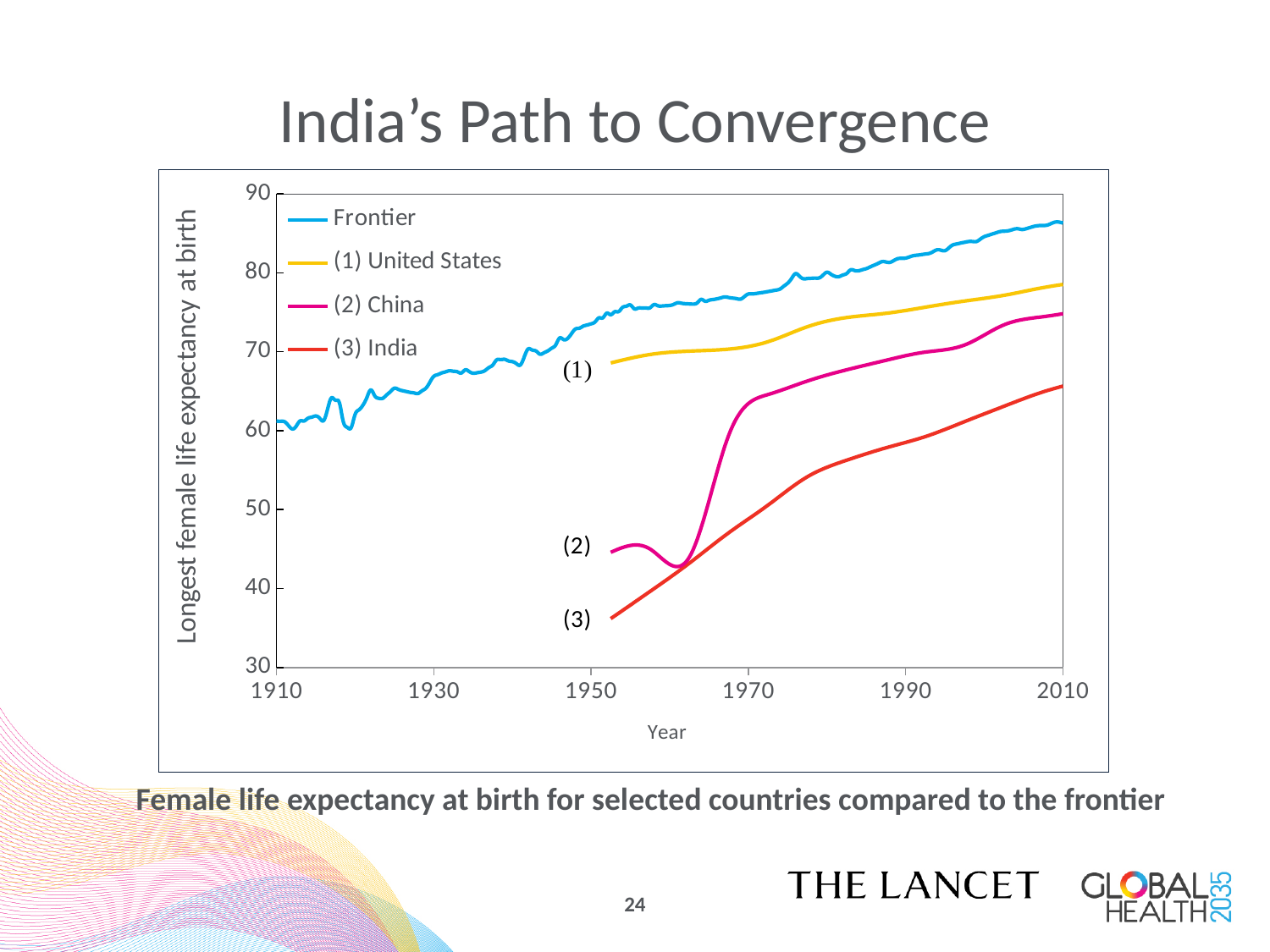
Does the Frontier series rise or fall from 1910 to 2010? rise Is the value for the Frontier in 1910 greater or less than 70? less Is the value for (3) India at the start of its line (around 1950) greater or less than 40? less Around 1970, which is higher, (2) China or (3) India? (2) China What is the label of the horizontal axis? Year What is the label of the vertical axis? Longest female life expectancy at birth Is the value for (3) India in 2010 greater or less than 60? greater In 2010, which is higher, (1) United States or (2) China? (1) United States Which series has the lowest value in 2010? (3) India How many series does the legend list? 4 What kind of chart is shown on the slide? line chart Which series has the highest value in 2010? Frontier